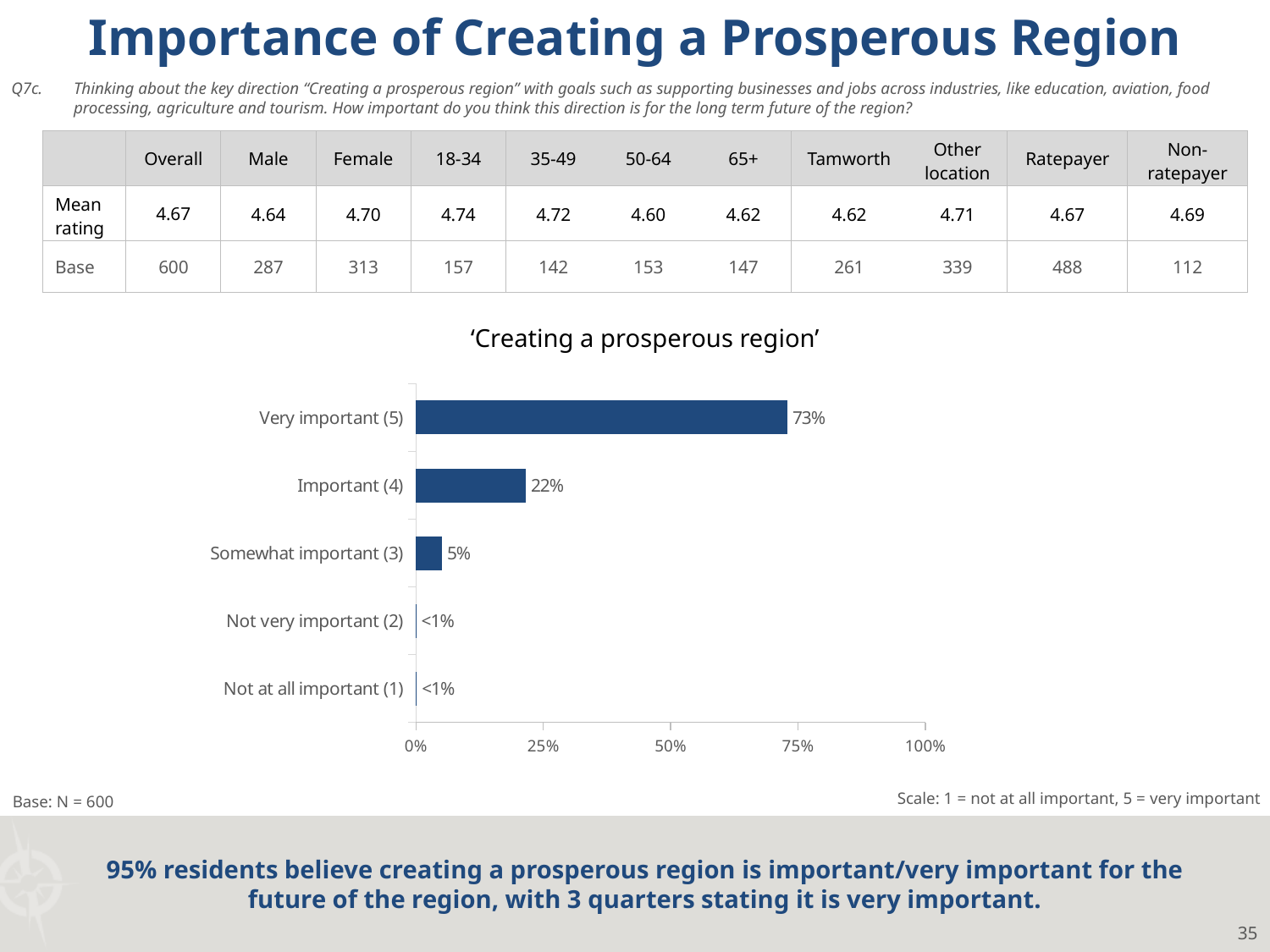
What percentage of respondents rated 'Creating a prosperous region' as Very important (5)? 73% Which is larger: the percentage for Important (4) or for Somewhat important (3)? Important (4) What value is shown for Not very important (2) in the chart? <1% How many rating categories are shown in the chart? 5 What percentage of respondents rated 'Creating a prosperous region' as Somewhat important (3)? 5% Which rating category has the highest percentage in the chart? Very important (5) What is the difference in percentage points between Very important (5) and Important (4)? 51 Is the value for Very important (5) greater or less than 50%? greater What percentage of respondents rated 'Creating a prosperous region' as Important (4)? 22% What type of chart is used to show the ratings for 'Creating a prosperous region'? Bar chart Is the value for Important (4) greater or less than 25%? less What is the title of the chart? 'Creating a prosperous region'